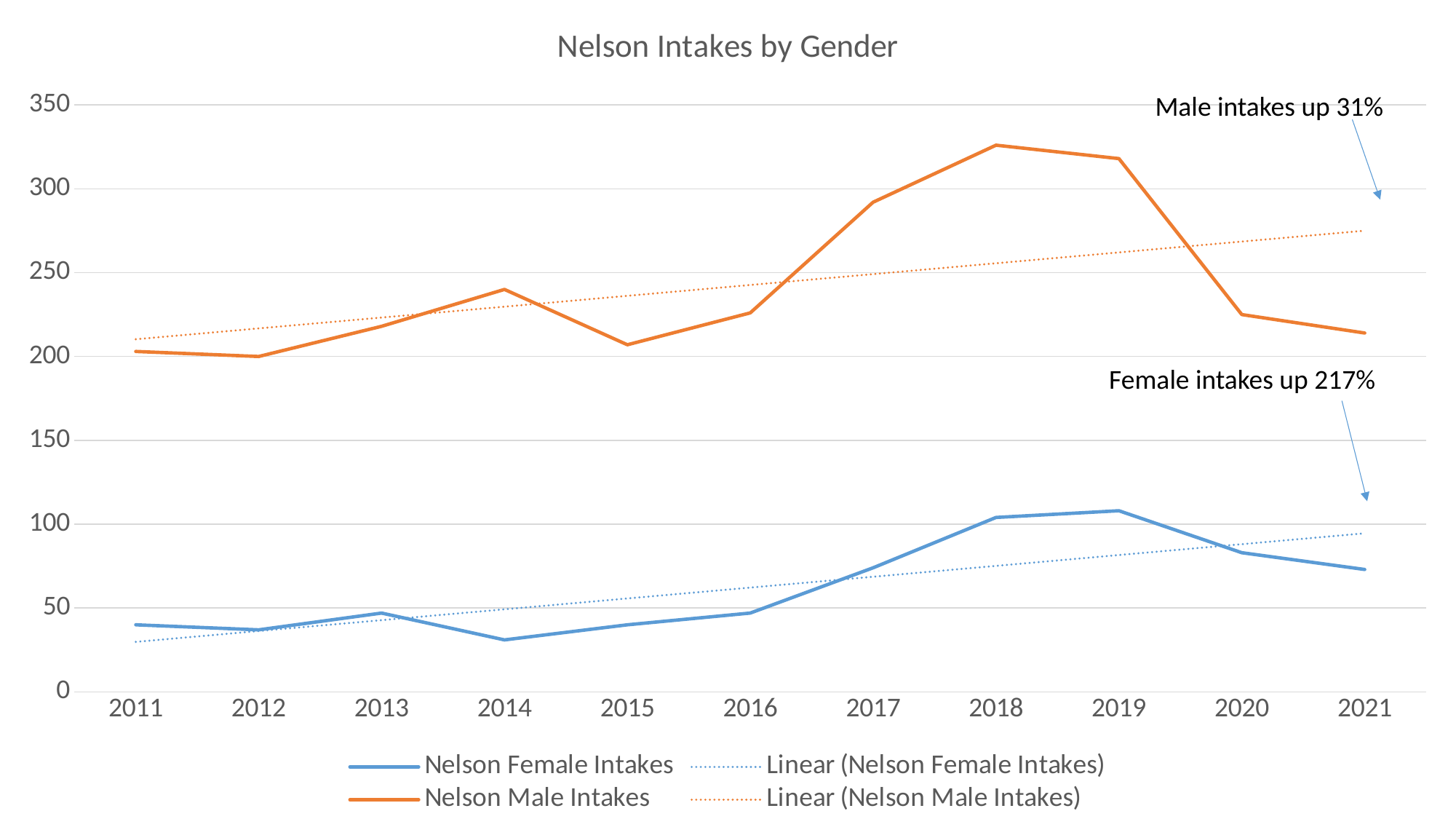
Which is larger: Nelson Male Intakes in 2018 or Nelson Male Intakes in 2021? 2018 Is the value for Nelson Male Intakes in 2017 greater or less than 250? greater What is the title of the chart? Nelson Intakes by Gender In which year do Nelson Male Intakes reach their highest value? 2018 How many entries does the legend list? 4 How many years are shown on the x axis? 11 According to the annotation on the chart, by what percentage are female intakes up? 217% Is the value for Nelson Female Intakes in 2014 greater or less than 50? less Is the value for Nelson Male Intakes in 2020 greater or less than 250? less In which year do Nelson Female Intakes reach their lowest value? 2014 What kind of chart is shown on the slide? Line chart Do Nelson Male Intakes rise or fall from 2019 to 2020? Fall